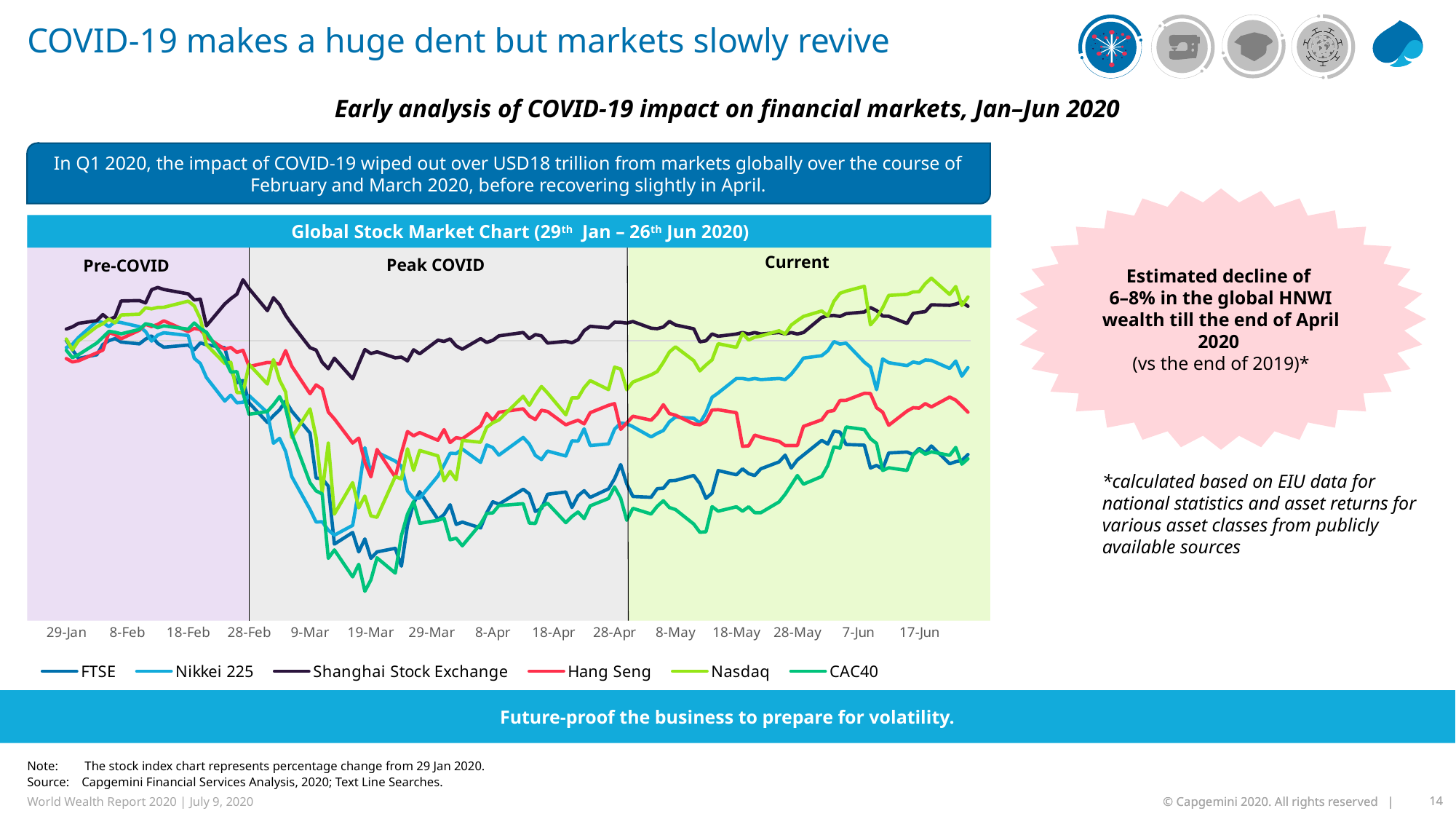
What kind of chart is the Global Stock Market Chart? line chart Which series is the highest in the Global Stock Market Chart during most of the Peak COVID period? Shanghai Stock Exchange Which series is the highest in the Global Stock Market Chart around 17-Jun? Nasdaq What is the title of the chart on the slide? Global Stock Market Chart (29th Jan – 26th Jun 2020) In the Global Stock Market Chart, does the Hang Seng line rise or fall between 28-Feb and 19-Mar? fall Which series is the lowest in the Global Stock Market Chart around 19-Mar? CAC40 How many date labels are shown along the x axis of the Global Stock Market Chart? 15 In the Global Stock Market Chart, does the Nasdaq line rise or fall between 28-Apr and 7-Jun? rise Which series in the Global Stock Market Chart is drawn in red? Hang Seng Around 19-Mar, which series is higher in the Global Stock Market Chart: Shanghai Stock Exchange or Nikkei 225? Shanghai Stock Exchange How many series does the legend of the Global Stock Market Chart list? 6 Around 17-Jun, which series is higher in the Global Stock Market Chart: Nasdaq or CAC40? Nasdaq